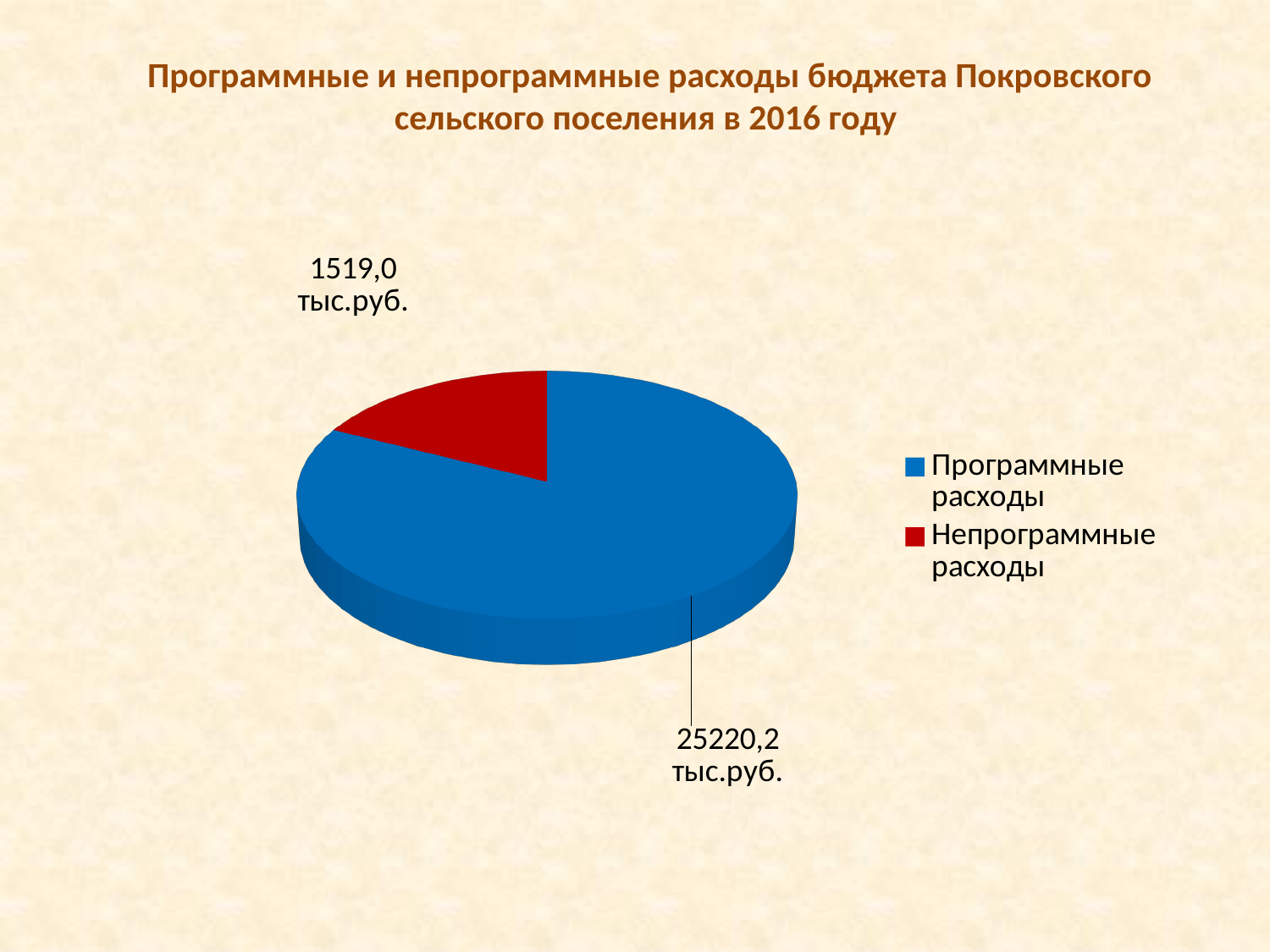
What kind of chart is shown on the slide? Pie chart Which category has the largest slice of the pie? Программные расходы What is the value for Непрограммные расходы? 1519,0 тыс.руб. What is the difference between Программные расходы and Непрограммные расходы? 23701,2 тыс.руб. How many entries does the legend list? 2 Which category has the smallest slice of the pie? Непрограммные расходы How many categories does the pie chart have? 2 Which is larger, Программные расходы or Непрограммные расходы? Программные расходы What colour is the slice for Непрограммные расходы? Red What is the value for Программные расходы? 25220,2 тыс.руб. What is the total of the two slices in the pie? 26739,2 тыс.руб.